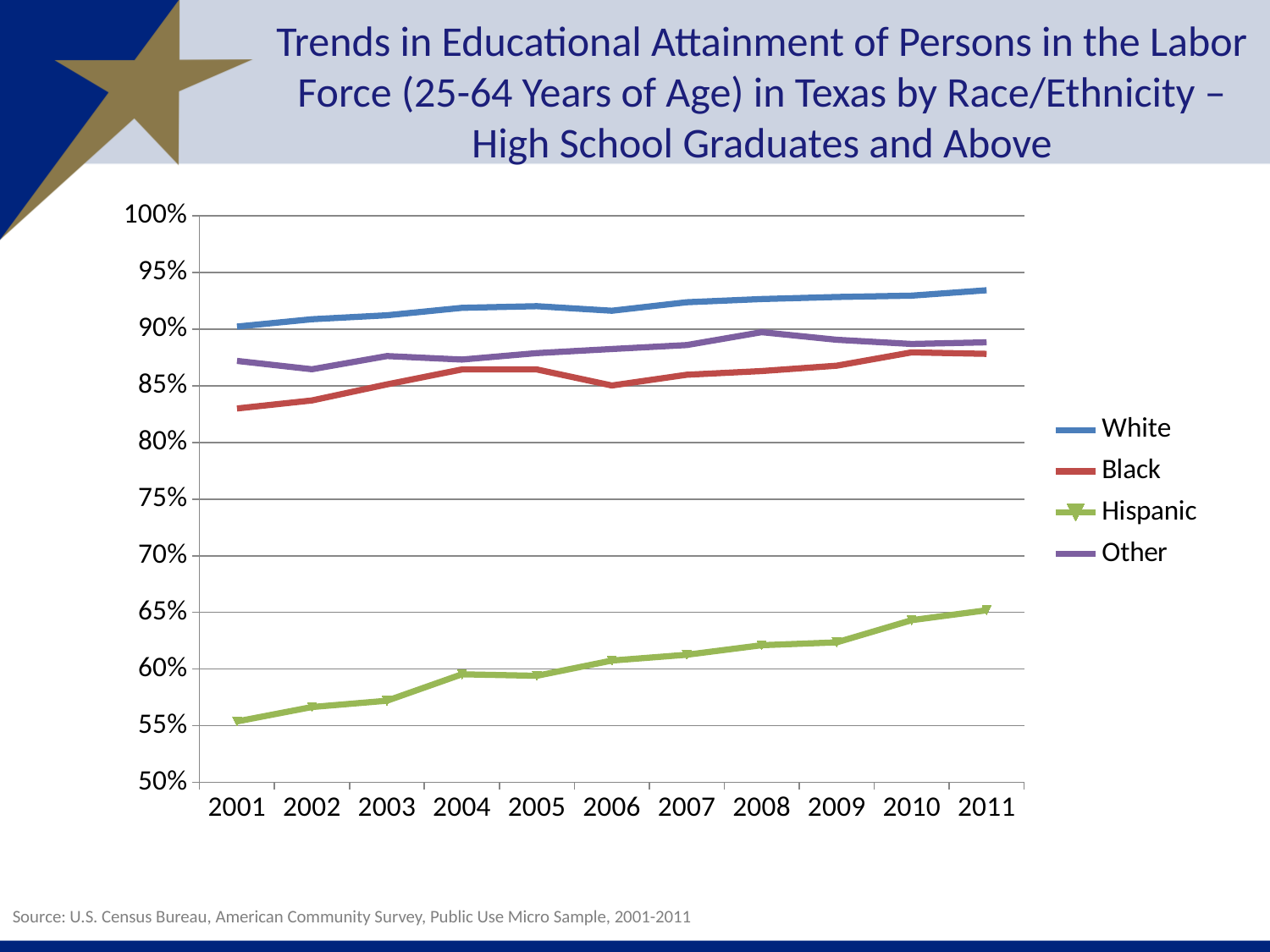
Is the value for Hispanic in 2011 greater or less than 60%? greater What are the four entries listed in the legend? White, Black, Hispanic, Other Is the value for White in 2011 greater or less than 90%? greater Does the Hispanic line rise or fall from 2001 to 2011? rises How many series does the legend list? 4 How many years are shown along the x axis? 11 Which series has the lowest value in 2011? Hispanic In 2008, which is higher: the value for Other or the value for Black? Other Is the value for Hispanic in 2001 greater or less than 60%? less Which series has the highest value in 2011? White What kind of chart is shown on the slide? line chart